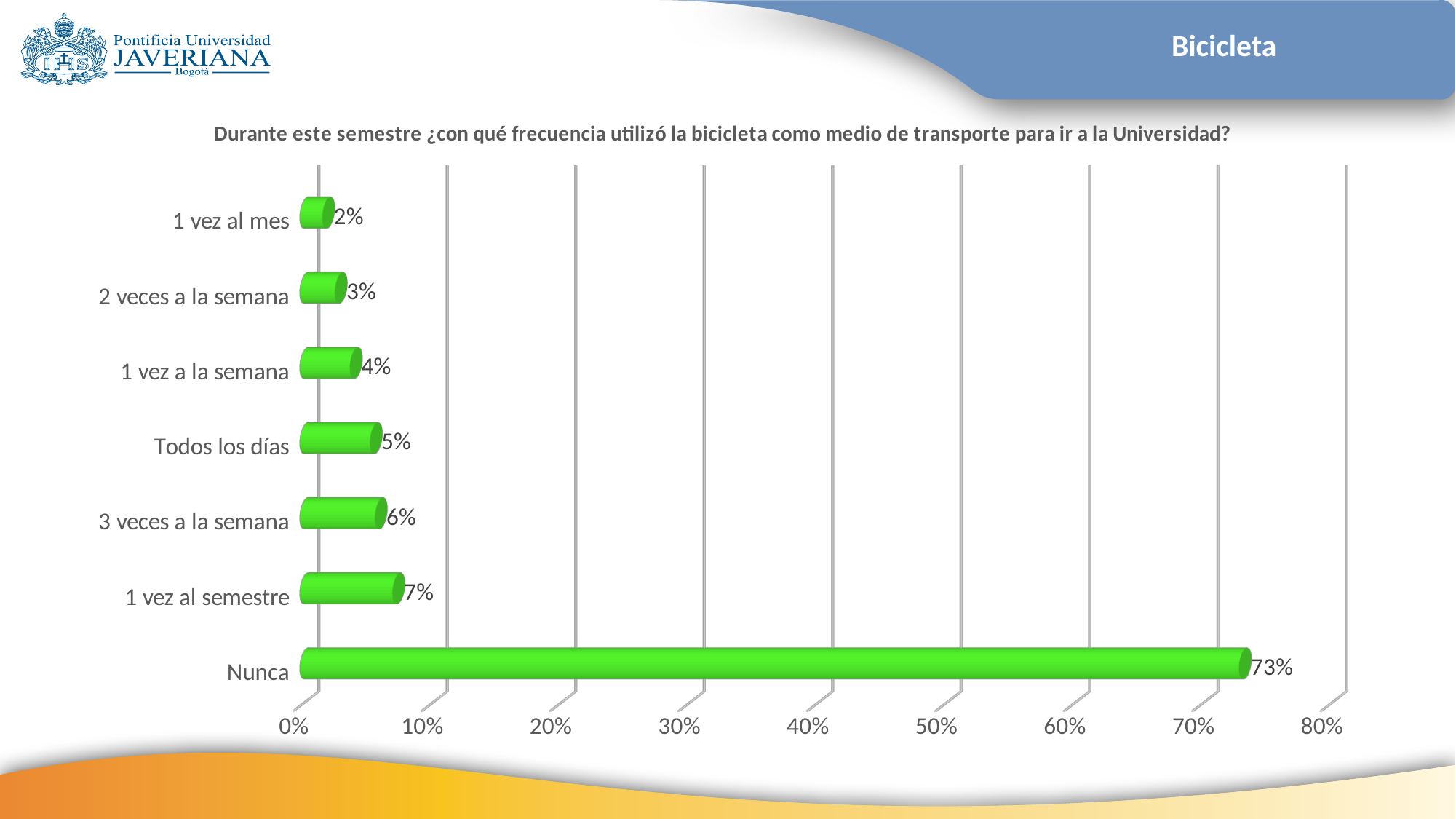
Is the value for "Nunca" greater or less than 70%? greater What is the difference between the values for "Nunca" and "1 vez al semestre"? 66% What kind of chart is shown on the slide? Bar chart What is the value for "Todos los días"? 5% What percentage of respondents answered "Nunca"? 73% What is the value for "1 vez al semestre"? 7% What is the title of the chart? Durante este semestre ¿con qué frecuencia utilizó la bicicleta como medio de transporte para ir a la Universidad? Which category has the highest value? Nunca Which category has the lowest value? 1 vez al mes What is the value for "1 vez al mes"? 2% Which is larger, the value for "3 veces a la semana" or "2 veces a la semana"? 3 veces a la semana How many categories are shown in the chart? 7